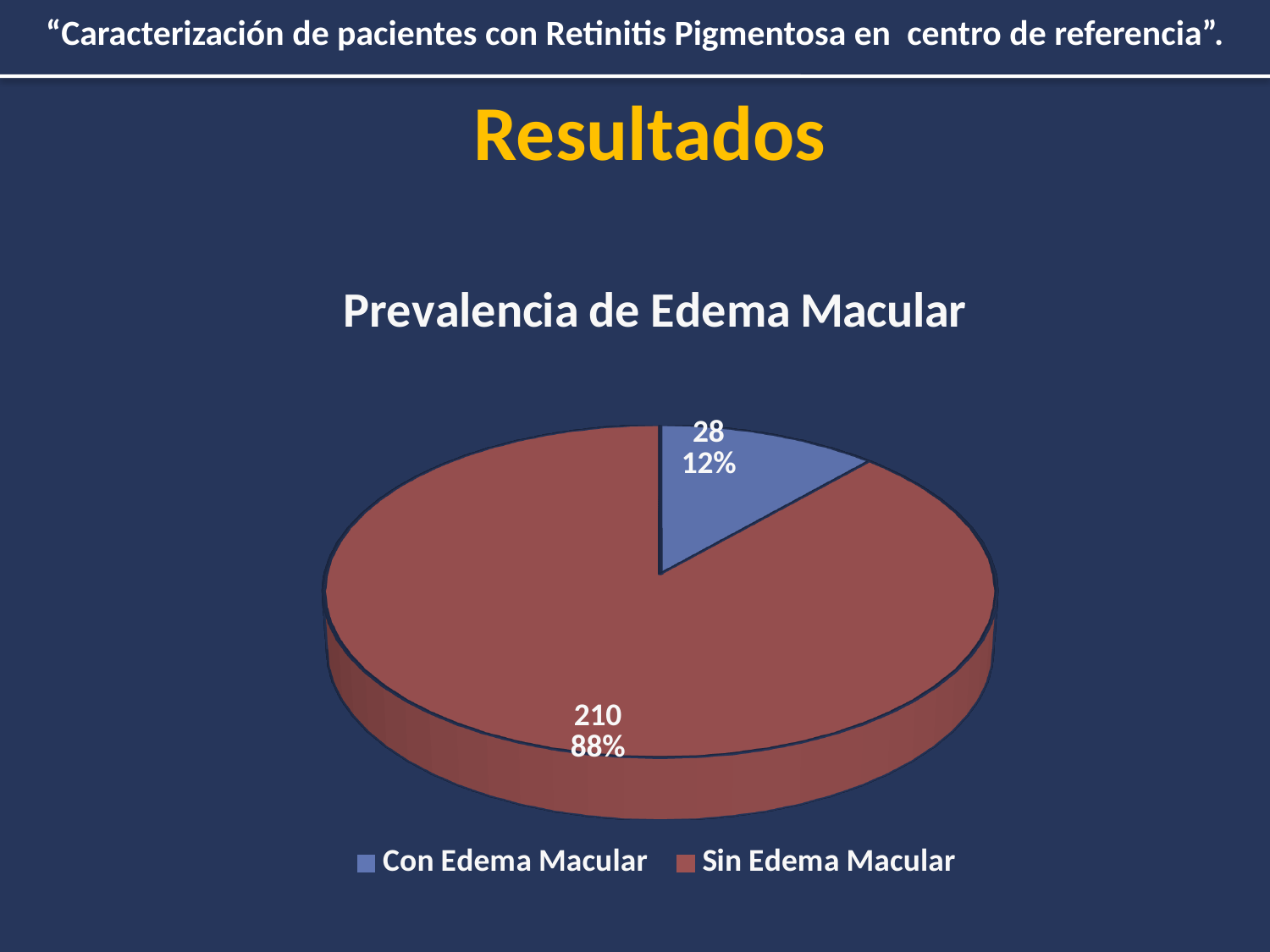
What percentage of the pie does 'Sin Edema Macular' represent? 88% What type of chart is shown on the slide? Pie chart What is the total number of patients represented in the pie chart? 238 Which category has the smallest slice of the pie? Con Edema Macular How many patients are in the 'Con Edema Macular' category? 28 Which is larger, the value for 'Con Edema Macular' or 'Sin Edema Macular'? Sin Edema Macular What is the difference in patient count between 'Sin Edema Macular' and 'Con Edema Macular'? 182 What is the title of the chart? Prevalencia de Edema Macular Which category has the largest slice of the pie? Sin Edema Macular What percentage of the pie does 'Con Edema Macular' represent? 12% How many patients are in the 'Sin Edema Macular' category? 210 How many categories does the legend list? 2